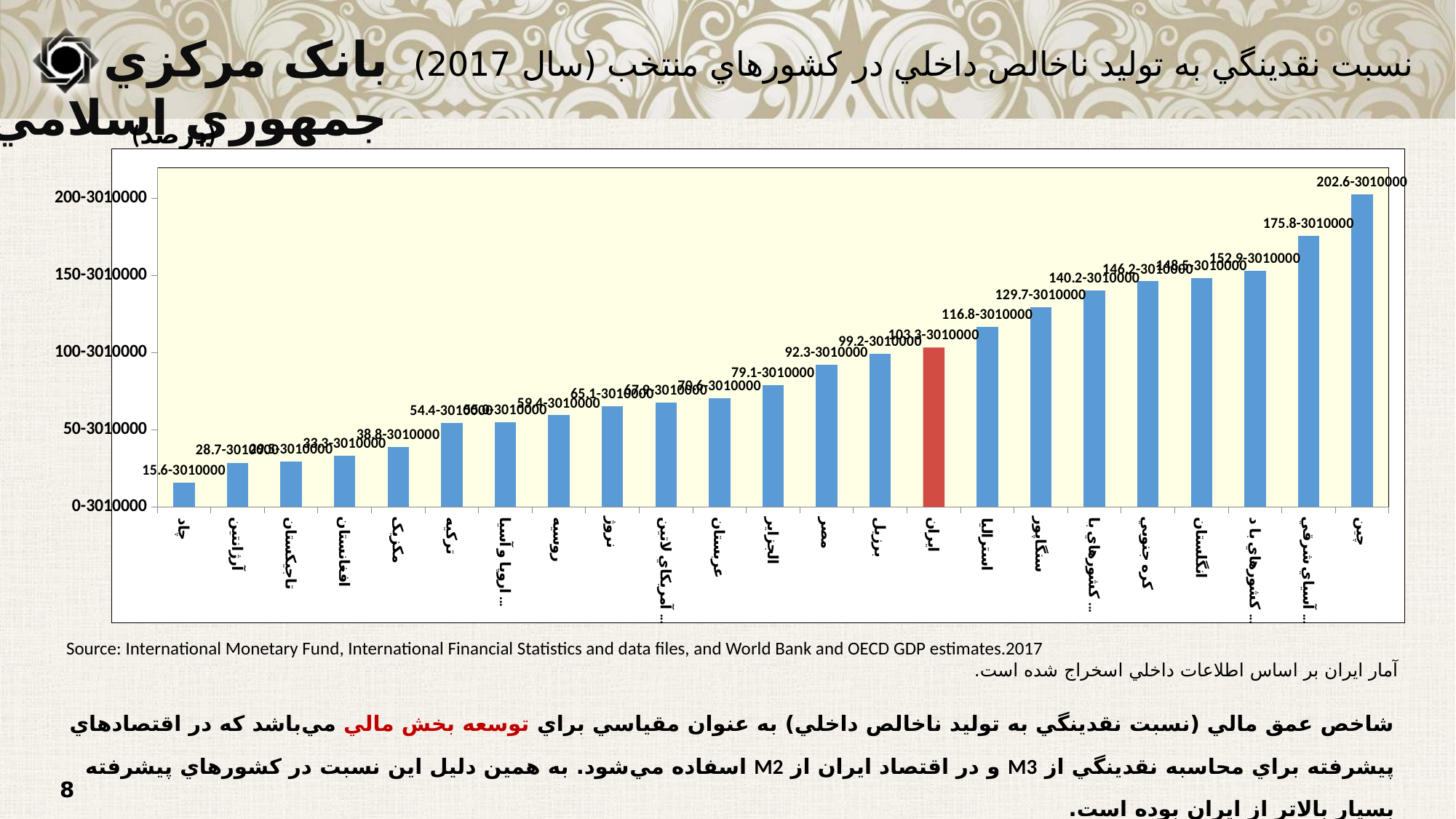
What is the data label printed above the bar for چاد? 15.6-3010000 Which bar is larger, ایران or برزیل? ایران Which country has the highest value in the chart? چین How many bars (categories) are plotted in the chart? 23 Which country's bar is coloured red instead of blue? ایران What kind of chart is shown on the slide? bar chart Which bar is larger, مصر or الجزایر? مصر Do the bar values rise or fall from left to right along the x axis? rise What is the data label printed above the bar for ایران? 103.3-3010000 Which country has the lowest value in the chart? چاد Which bar is larger, استرالیا or سنگاپور? سنگاپور What is the data label printed above the bar for چین? 202.6-3010000